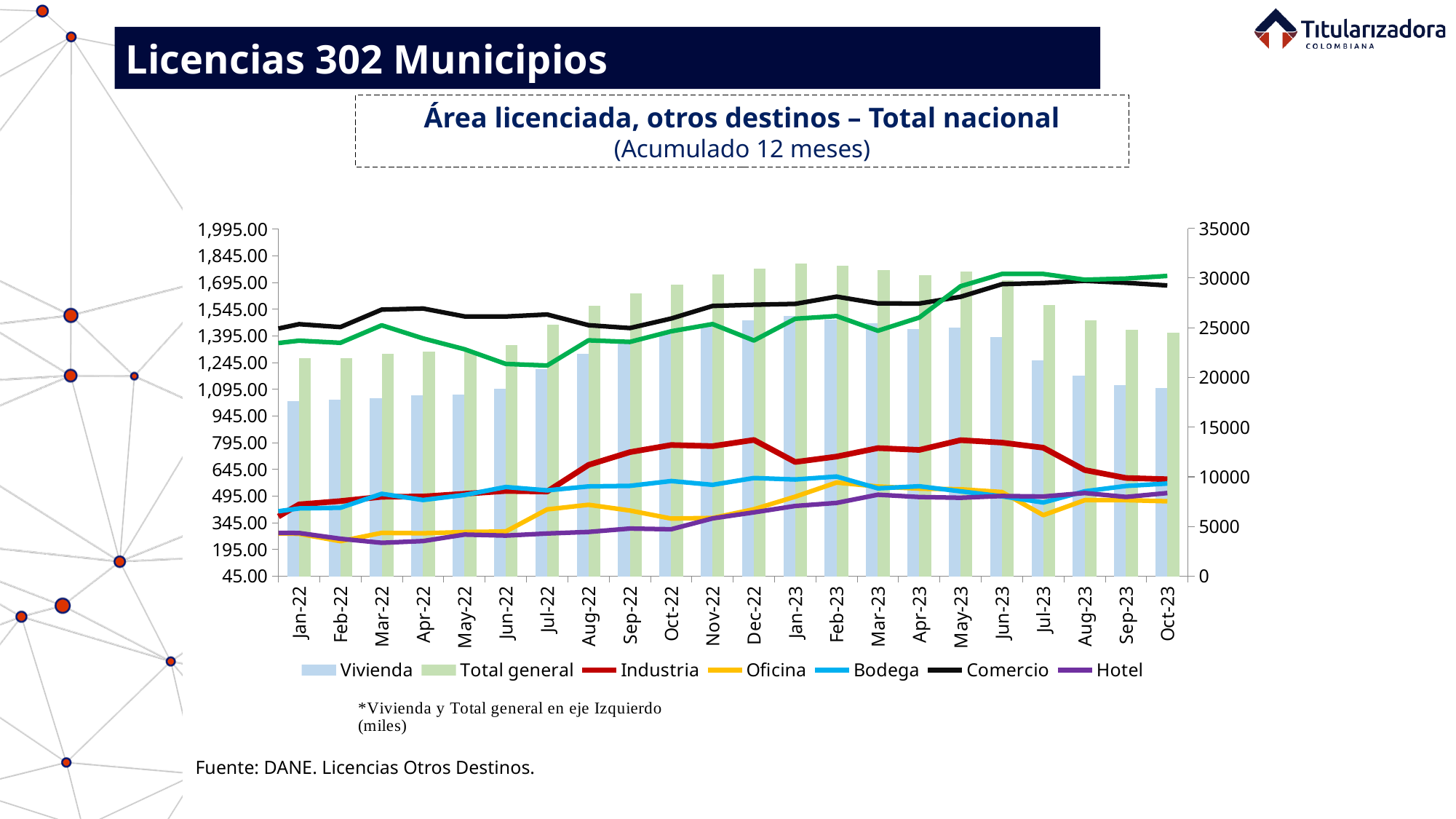
Do the Vivienda bars rise or fall from Feb-23 to Oct-23? fall Is the value for Industria in Jan-22 greater or less than 10000? less What is the title of the chart? Área licenciada, otros destinos – Total nacional (Acumulado 12 meses) How many series does the legend list? 7 Is the Total general bar for Jan-23 greater or less than 1,695.00? greater What kind of chart is shown on the slide? A combined bar and line chart Which is larger in Dec-22, the Vivienda bar or the Total general bar? Total general Which is larger in Dec-22, Industria or Hotel? Industria Which two series are plotted as bars? Vivienda and Total general How many months are plotted along the x axis? 22